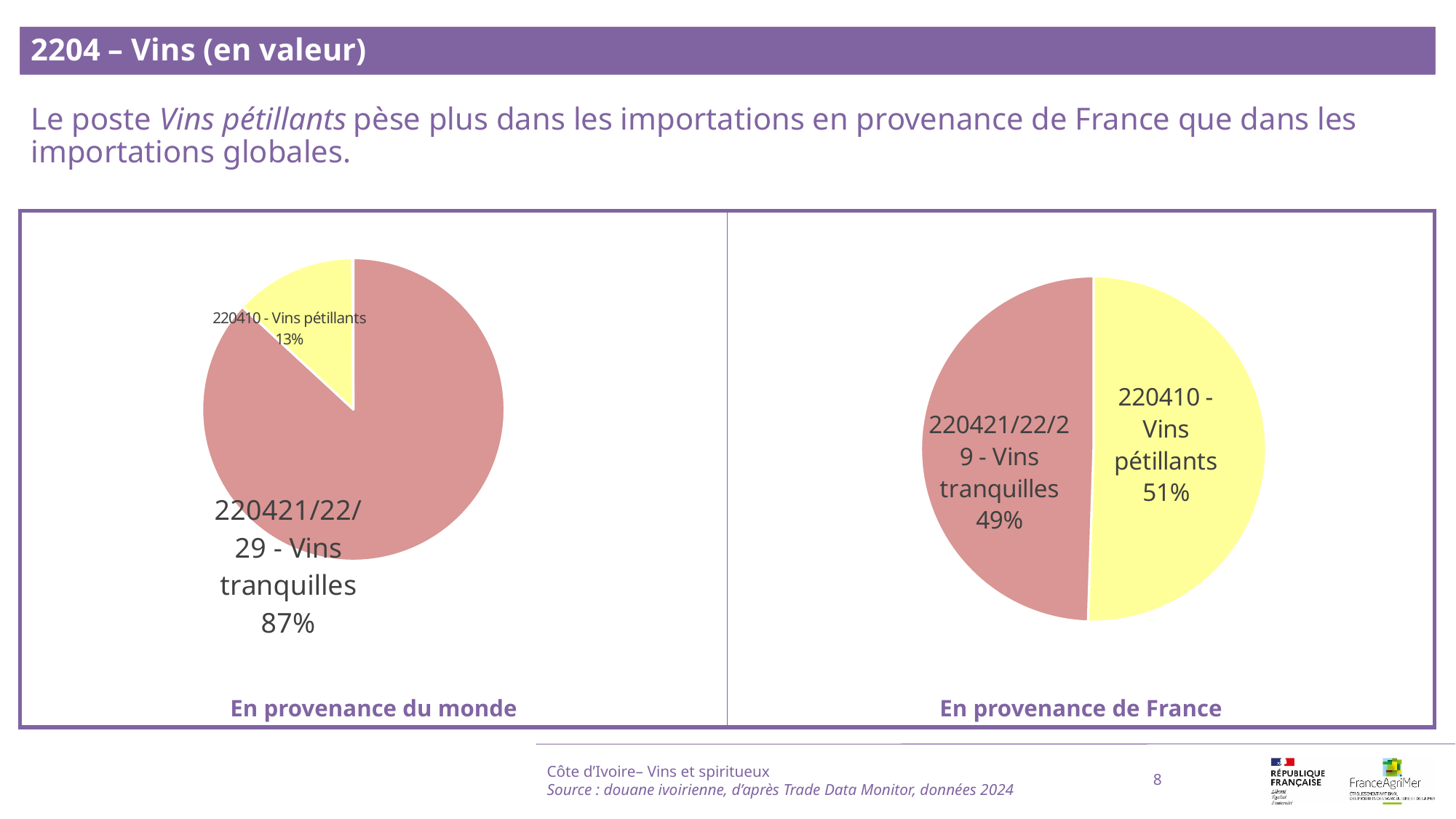
How many pie charts are on the slide? 2 In the 'En provenance de France' chart, which category has the smallest slice? 220421/22/29 - Vins tranquilles In the 'En provenance de France' chart, what share do Vins tranquilles (220421/22/29) represent? 49% What type of chart is used on this slide? Pie chart In the 'En provenance du monde' chart, what is the difference in percentage points between Vins tranquilles and Vins pétillants? 74 percentage points What colour is the Vins pétillants slice in both charts? Yellow In the 'En provenance du monde' chart, what share do Vins tranquilles (220421/22/29) represent? 87% Is the share of Vins pétillants larger in the 'En provenance du monde' chart or in the 'En provenance de France' chart? En provenance de France In the 'En provenance du monde' chart, what share do Vins pétillants (220410) represent? 13% In the 'En provenance du monde' chart, which category has the largest slice? 220421/22/29 - Vins tranquilles How many categories does the 'En provenance de France' chart show? 2